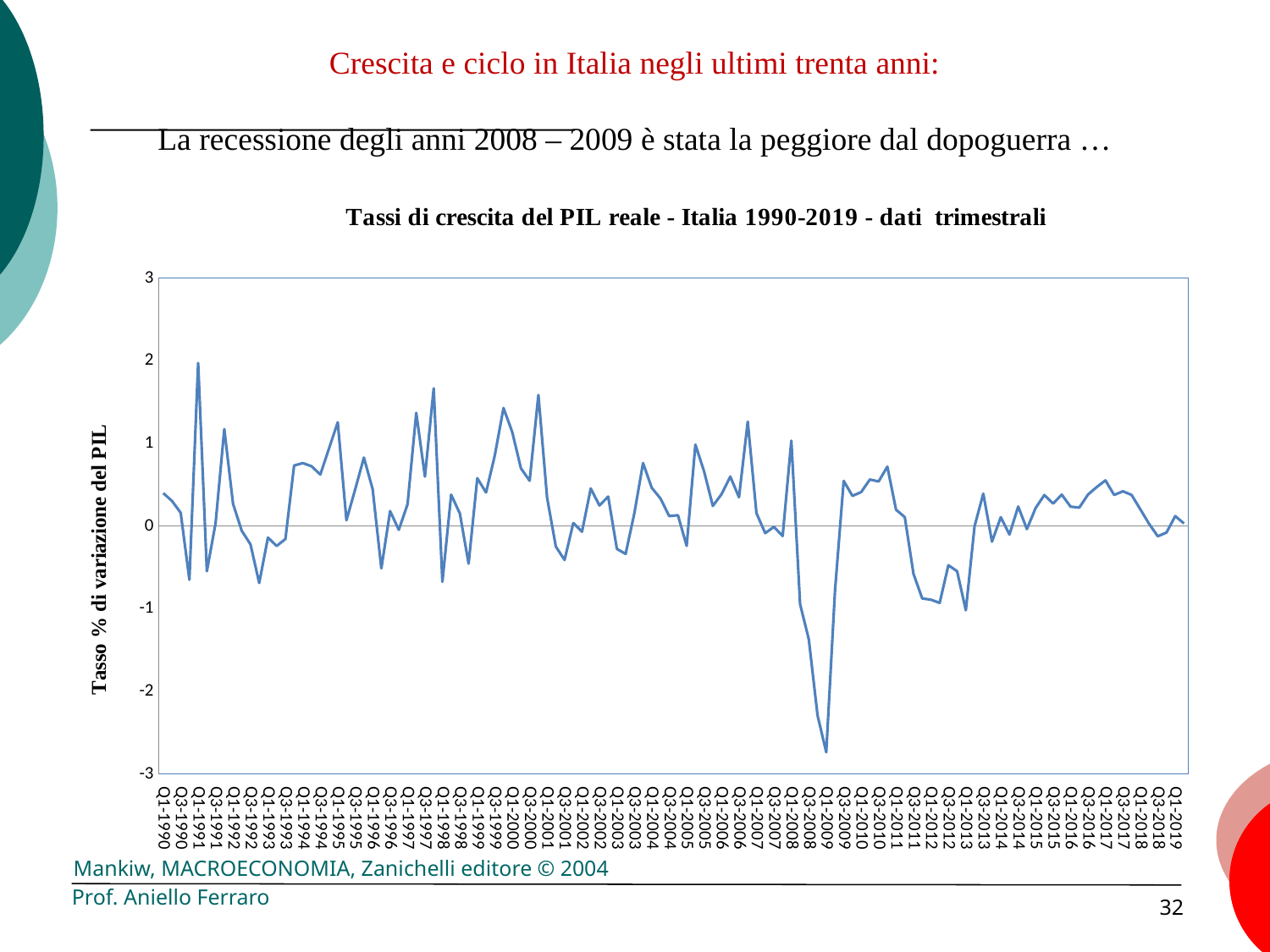
Which is larger, the value for Q1-2008 or the value for Q1-2009? Q1-2008 Is the value for Q1-1991 greater or less than 1? greater Is the value for Q3-1997 greater or less than 1? less In which quarter does the line reach its lowest value? Q1-2009 What is the label of the vertical axis? Tasso % di variazione del PIL What kind of chart is shown on the slide? Line chart Is the value for Q1-2009 greater or less than -2? less In which quarter does the line reach its highest value? Q1-1991 Does the line rise or fall between Q1-2008 and Q1-2009? Fall What is the title of the chart? Tassi di crescita del PIL reale - Italia 1990-2019 - dati trimestrali What is the highest value shown on the vertical axis? 3